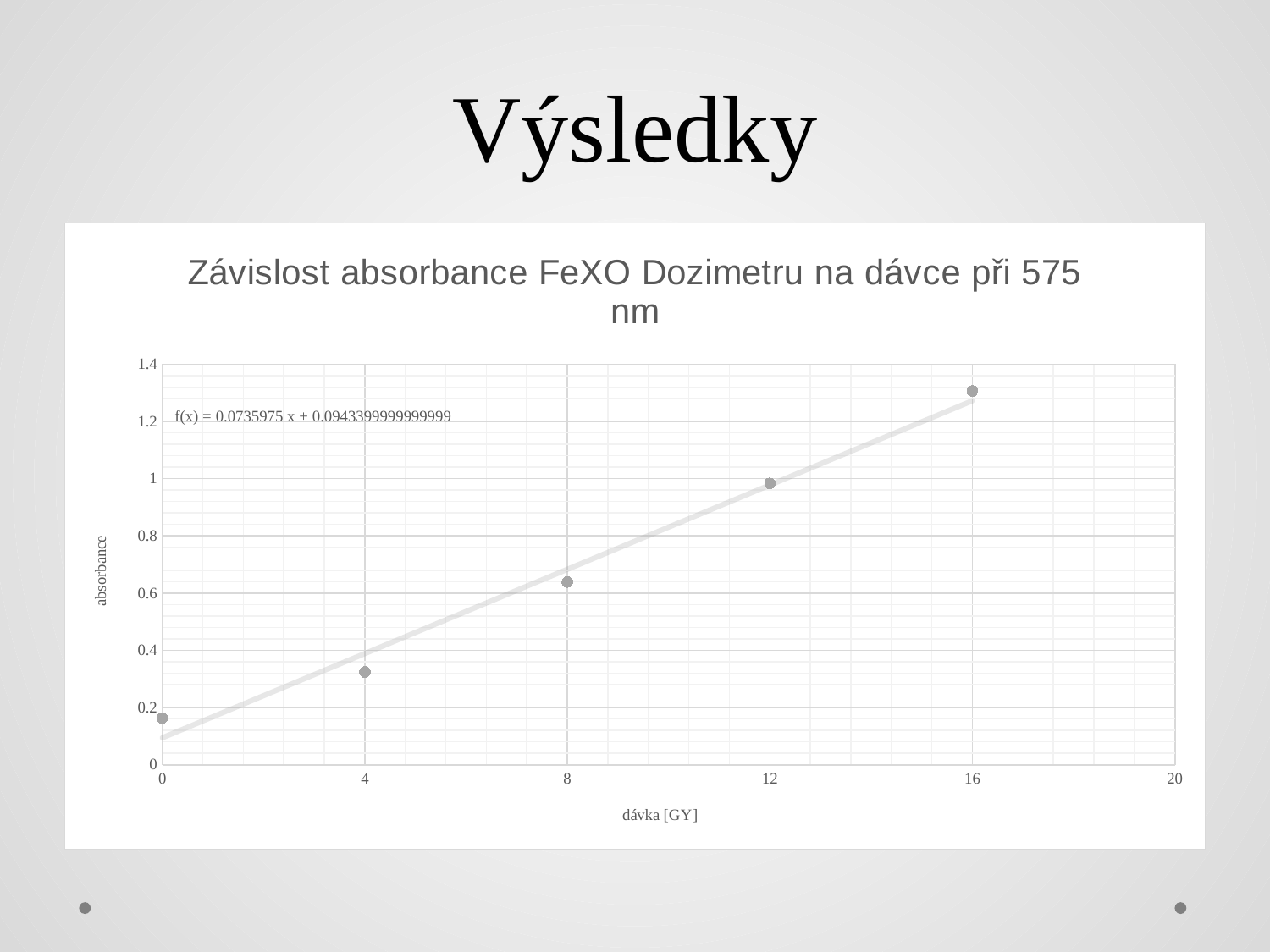
Do the absorbance values rise or fall as the dose increases along the x axis? rise What is the title of the chart? Závislost absorbance FeXO Dozimetru na dávce při 575 nm What kind of chart is shown on the slide? scatter chart How many data points are plotted in the chart? 5 Is the absorbance at a dose of 16 GY greater or less than 1.2? greater What is the trendline equation printed on the chart? f(x) = 0.0735975 x + 0.09433999999999999 Is the absorbance at a dose of 8 GY greater or less than 0.8? less At which dose is the absorbance highest? 16 At which dose is the absorbance lowest? 0 Which has the larger absorbance, the point at dose 4 or the point at dose 12? dose 12 Is the absorbance at a dose of 4 GY greater or less than 0.2? greater